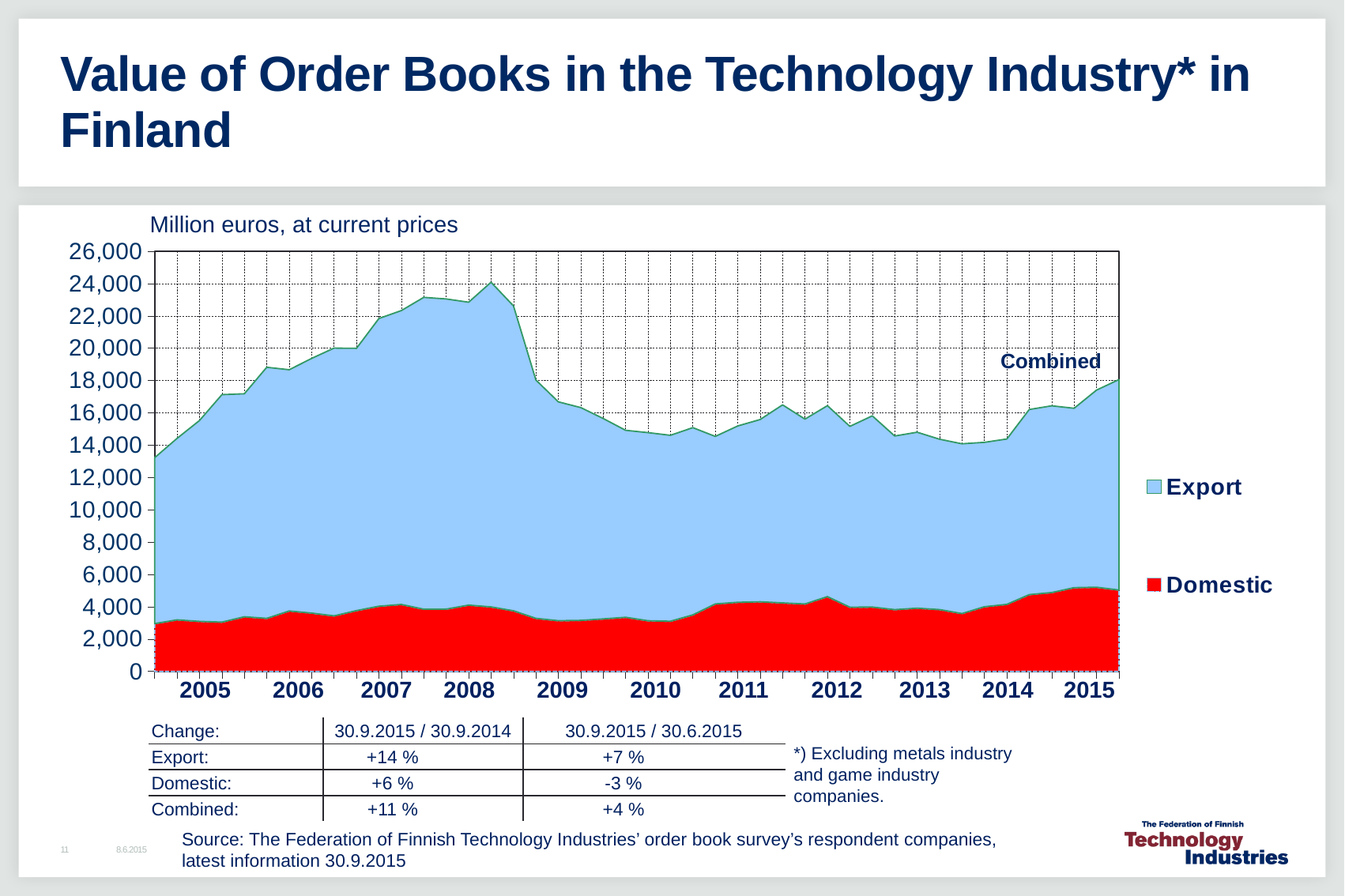
Does the combined value of order books rise or fall between 2008 and 2009? fall In which year does the combined value of order books reach its highest point? 2008 What kind of chart is shown on the slide? Stacked area chart How many years are labelled on the x axis of the chart? 11 Is the combined value in 2013 greater or less than 16,000? less Is the peak combined value in 2008 greater or less than 22,000? greater Does the combined value of order books rise or fall between 2013 and 2015? rise In what unit are the values on the chart expressed? Million euros, at current prices Is the Domestic value at the end of 2015 greater or less than 4,000? greater How many series does the chart legend list? 2 What are the two series named in the chart legend? Export and Domestic Which series is larger throughout the chart, Export or Domestic? Export